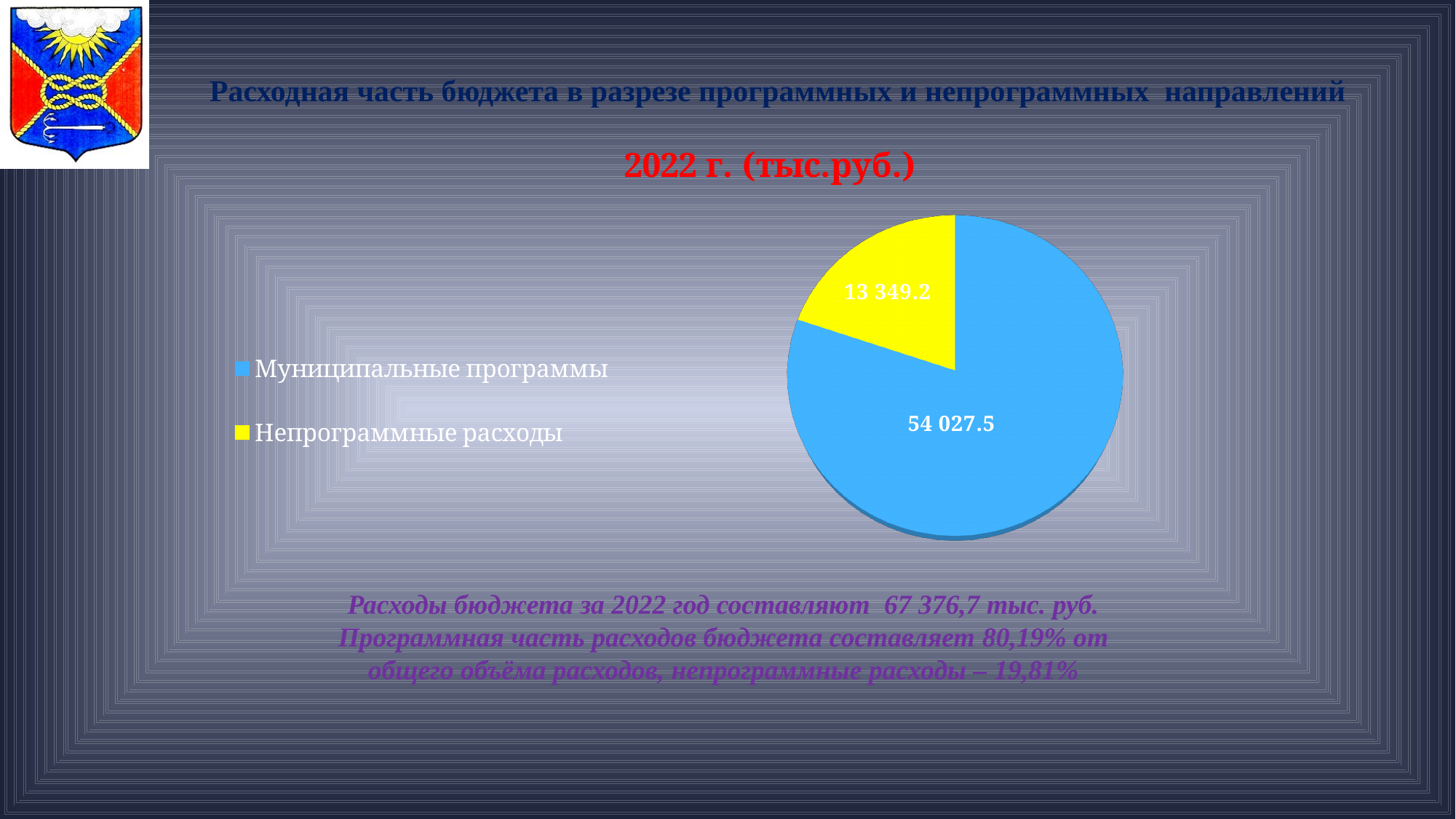
How many slices does the pie chart have? 2 What kind of chart is shown on the slide? Pie chart Which category has the largest slice in the pie chart? Муниципальные программы What is the value for Непрограммные расходы in the pie chart? 13 349.2 What share of the pie does Муниципальные программы represent, according to the slide? 80,19% What is the total of the two slices in the pie chart? 67 376.7 What is the value for Муниципальные программы in the pie chart? 54 027.5 Which is larger: Муниципальные программы or Непрограммные расходы? Муниципальные программы What is the difference between the values for Муниципальные программы and Непрограммные расходы? 40 678.3 What share of the pie does Непрограммные расходы represent, according to the slide? 19,81% What colour is the slice for Непрограммные расходы? Yellow Which category has the smallest slice in the pie chart? Непрограммные расходы